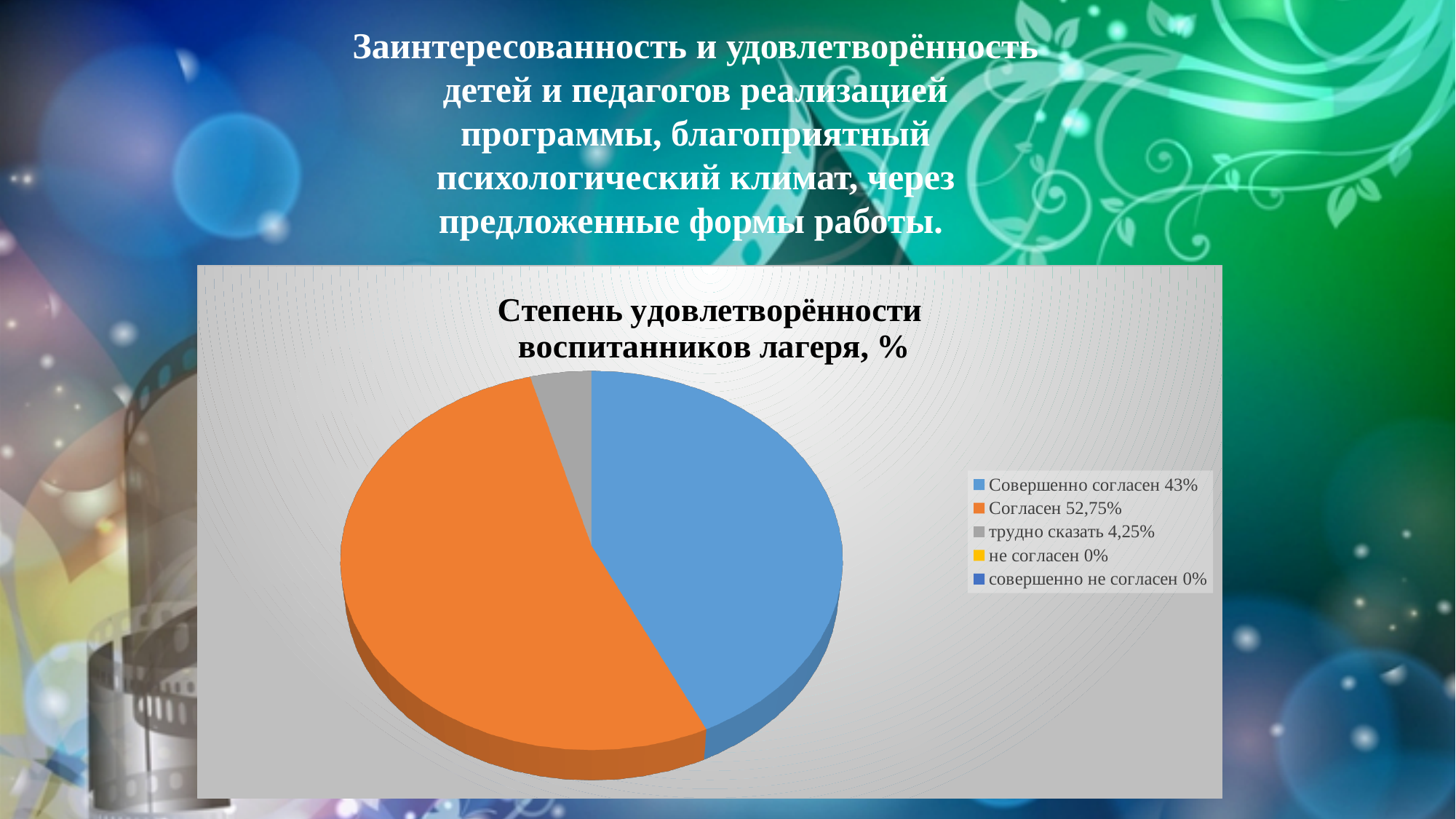
What type of chart is shown on the slide? pie chart What percentage is shown for "трудно сказать"? 4,25% How many categories have a share of 0%? 2 What percentage is shown for "Совершенно согласен"? 43% What is the difference between the shares for "Согласен" and "Совершенно согласен"? 9,75% How many entries does the legend list? 5 What colour is the slice for "Согласен"? orange What percentage is shown for "не согласен"? 0% Which category has the largest share of the pie? Согласен What percentage is shown for "Согласен"? 52,75% Which is larger, the share for "Совершенно согласен" or the share for "трудно сказать"? Совершенно согласен What is the title of the chart? Степень удовлетворённости воспитанников лагеря, %